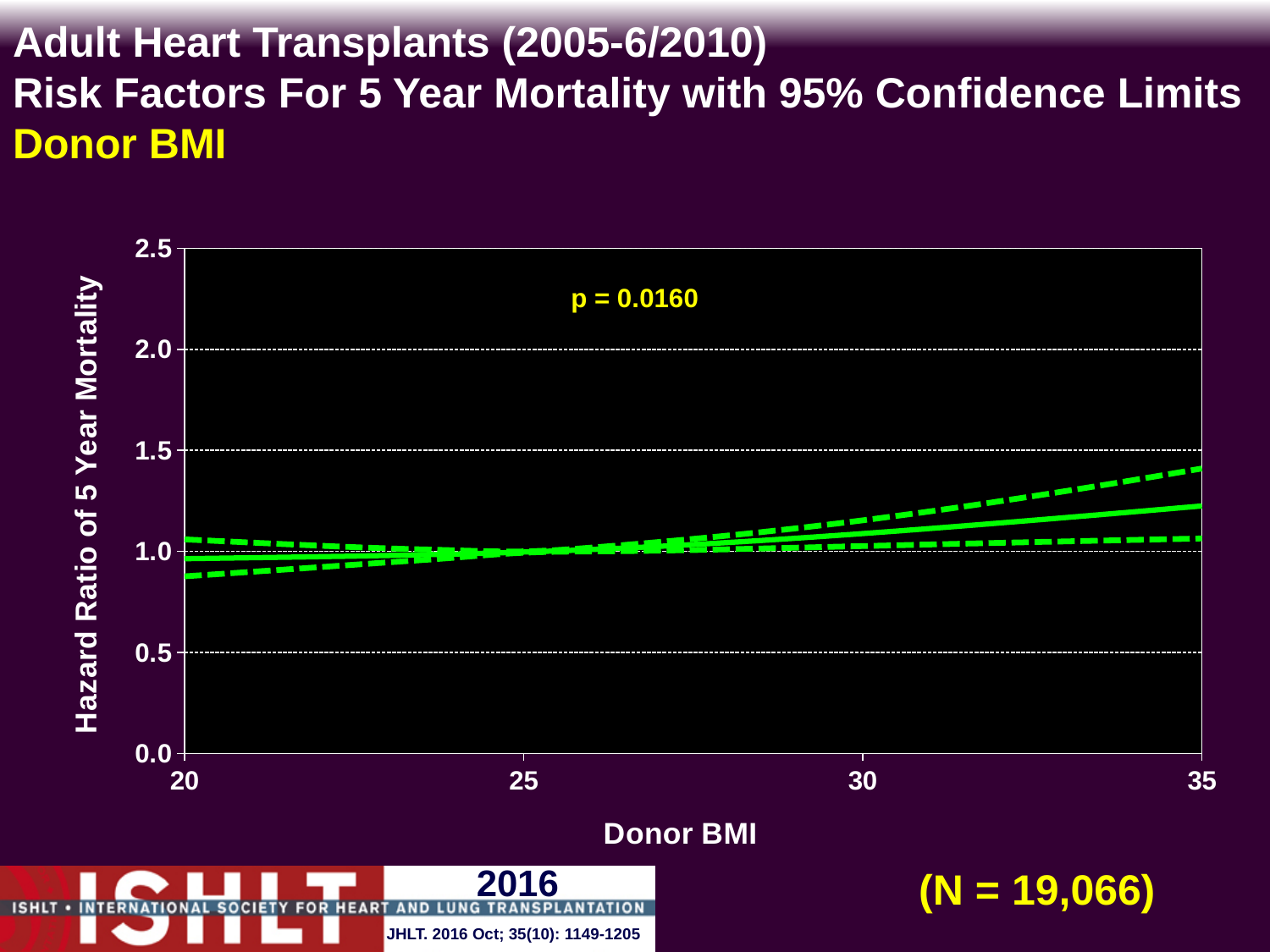
Is the hazard ratio higher at a donor BMI of 20 or at a donor BMI of 35? 35 Is the hazard ratio (solid line) at a donor BMI of 35 greater or less than 1.5? less How many lines are plotted on the chart? 3 Is the hazard ratio (solid line) at a donor BMI of 35 greater or less than 1.0? greater What kind of chart is shown on the slide? line chart What p-value is shown on the chart? p = 0.0160 Is the hazard ratio (solid line) at a donor BMI of 30 greater or less than 1.0? greater Does the hazard ratio of 5 year mortality rise or fall as donor BMI increases from 20 to 35? rise What is the sample size (N) shown on the slide? N = 19,066 At which donor BMI shown on the x axis is the hazard ratio highest? 35